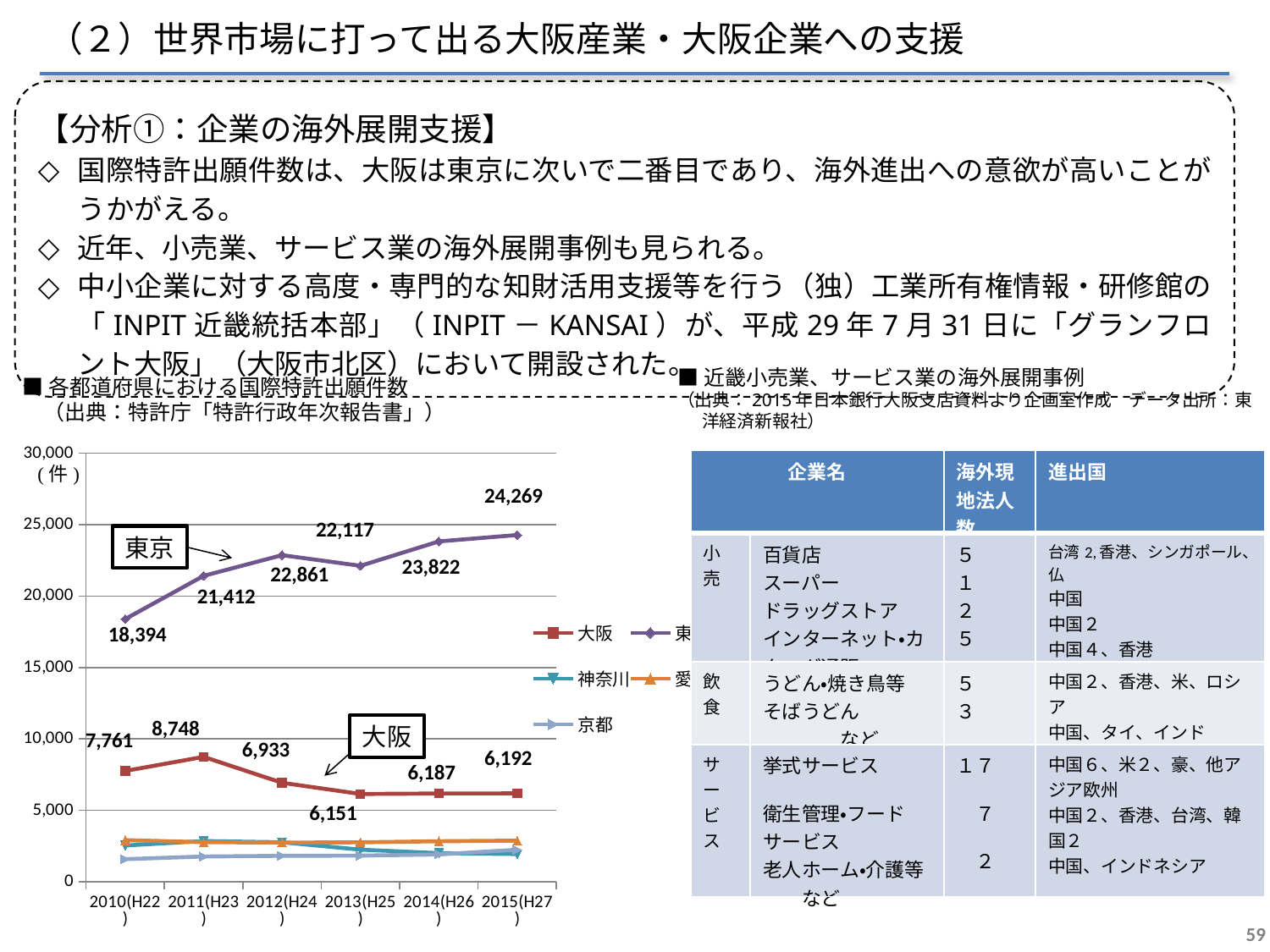
In the line chart of international patent applications by prefecture, what is the difference between the 東京 and 大阪 values in 2015(H27)? 18,077 In the line chart of international patent applications by prefecture, what is the value for 大阪 in 2013(H25)? 6,151 In the line chart of international patent applications by prefecture, in which year is the 東京 value highest? 2015(H27) In the line chart of international patent applications by prefecture, what is the value for 東京 in 2015(H27)? 24,269 In the line chart of international patent applications by prefecture, how many years are shown on the x axis? 6 In the line chart of international patent applications by prefecture, is the value for 京都 in 2015(H27) greater or less than 5,000? less In the line chart of international patent applications by prefecture, which is larger for 大阪: the 2011(H23) value or the 2012(H24) value? 2011(H23) In the line chart of international patent applications by prefecture, what is the value for 大阪 in 2010(H22)? 7,761 What kind of chart is used to show international patent applications by prefecture? line chart In the line chart of international patent applications by prefecture, by how much did the 東京 value increase from 2010(H22) to 2011(H23)? 3,018 In the line chart of international patent applications by prefecture, in which year is the 大阪 value lowest? 2013(H25) In the line chart of international patent applications by prefecture, what is the value for 東京 in 2010(H22)? 18,394